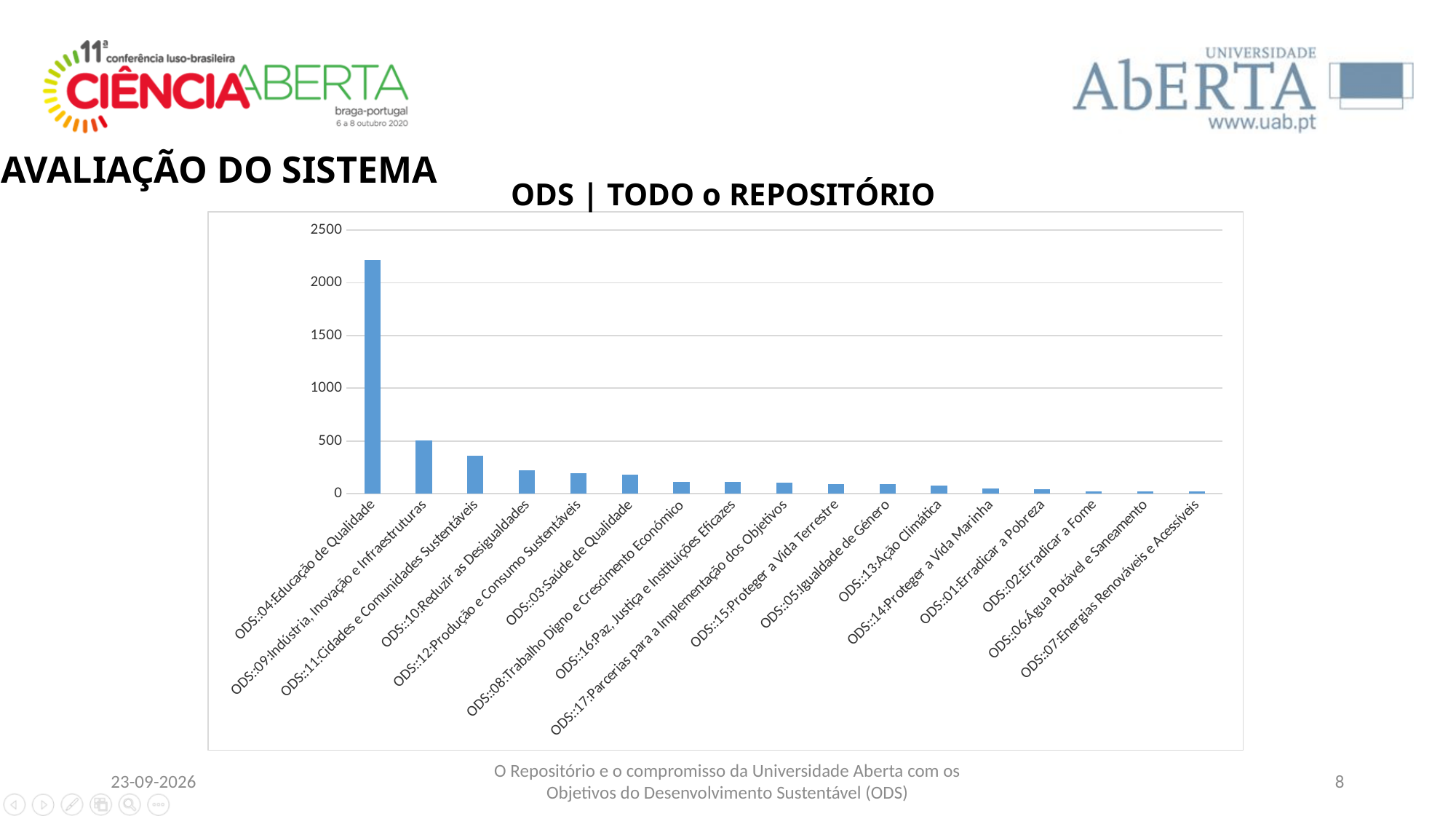
What is the title of the chart? ODS | TODO o REPOSITÓRIO Which has a larger value: ODS::11:Cidades e Comunidades Sustentáveis or ODS::10:Reduzir as Desigualdades? ODS::11:Cidades e Comunidades Sustentáveis Is the value for ODS::09:Indústria, Inovação e Infraestruturas greater or less than 1000? less What colour are the bars in the chart? Blue Which has a larger value: ODS::04:Educação de Qualidade or ODS::09:Indústria, Inovação e Infraestruturas? ODS::04:Educação de Qualidade How many categories (bars) are plotted in the chart? 17 Is the value for ODS::04:Educação de Qualidade greater or less than 2000? greater What kind of chart is shown on the slide? Bar chart Do the bar values rise or fall from left to right along the x axis? Fall Is the value for ODS::11:Cidades e Comunidades Sustentáveis greater or less than 500? less Which category has the highest value in the chart? ODS::04:Educação de Qualidade